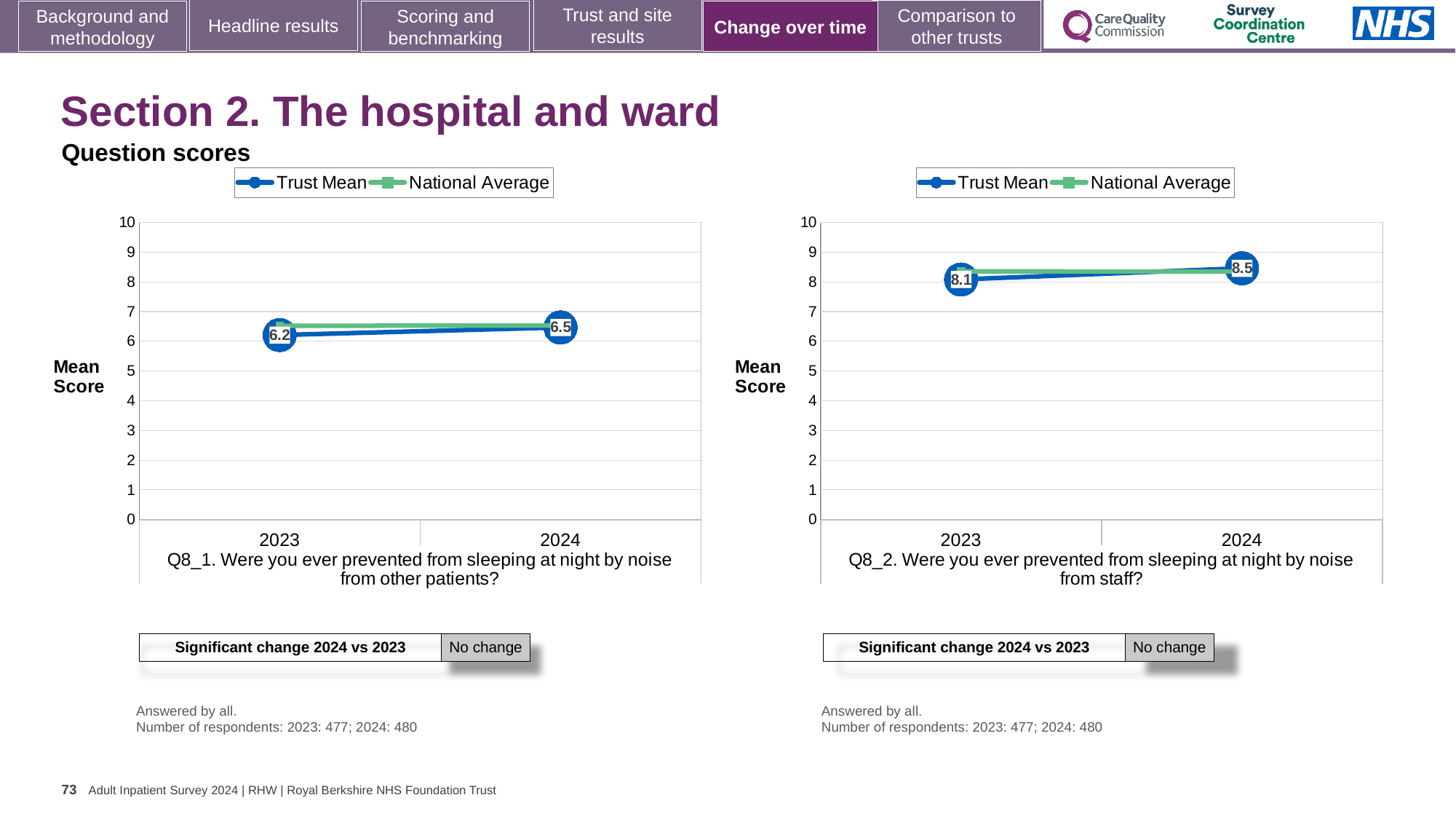
In the Q8_2 chart (right), what is the difference between the Trust Mean for 2024 and 2023? 0.4 In the Q8_2 chart (right), what is the Trust Mean score for 2023? 8.1 How many series does the legend of the Q8_2 chart (right) list? 2 In the Q8_1 chart (left), what is the Trust Mean score for 2023? 6.2 In the Q8_1 chart (left), what is the Trust Mean score for 2024? 6.5 Which chart has the higher Trust Mean for 2024, Q8_1 (left) or Q8_2 (right)? Q8_2 (right) In the Q8_1 chart (left), is the National Average for 2023 greater or less than 6? greater In the Q8_1 chart (left), by how much did the Trust Mean change from 2023 to 2024? 0.3 In the Q8_2 chart (right), does the Trust Mean rise or fall from 2023 to 2024? rise What type of chart is used for Q8_1 (left)? line chart How many years are plotted on the x axis of the Q8_1 chart (left)? 2 In the Q8_2 chart (right), what is the Trust Mean score for 2024? 8.5